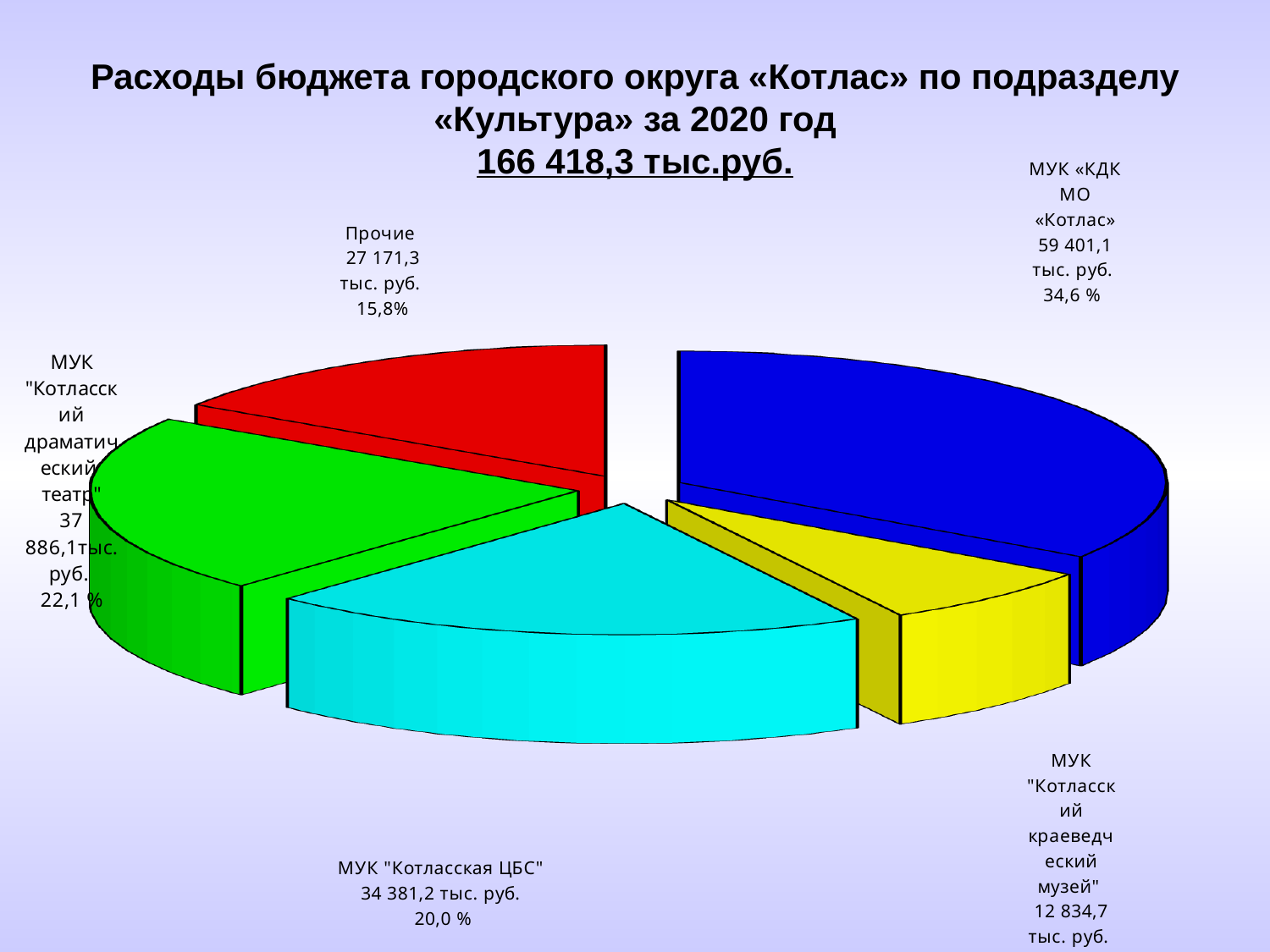
Какой тип диаграммы показан на слайде? Круговая диаграмма Какова сумма расходов по МУК "Котласский краеведческий музей"? 12 834,7 тыс. руб. Какую долю расходов составляет категория «Прочие»? 15,8% Какую долю расходов составляет МУК "Котласский драматический театр"? 22,1 % На сколько расходы по МУК «КДК МО «Котлас» больше расходов по МУК "Котласский драматический театр"? 21 515,0 тыс. руб. Сколько категорий (секторов) показано на круговой диаграмме? 5 Какая категория имеет наибольшие расходы? МУК «КДК МО «Котлас» Что больше: расходы по категории «Прочие» или по МУК "Котласская ЦБС"? МУК "Котласская ЦБС" Какая категория имеет наименьшие расходы? МУК "Котласский краеведческий музей" Какая общая сумма расходов указана в заголовке диаграммы? 166 418,3 тыс.руб. Какова сумма расходов по МУК "Котласская ЦБС"? 34 381,2 тыс. руб. Какова сумма расходов по МУК «КДК МО «Котлас»? 59 401,1 тыс. руб.